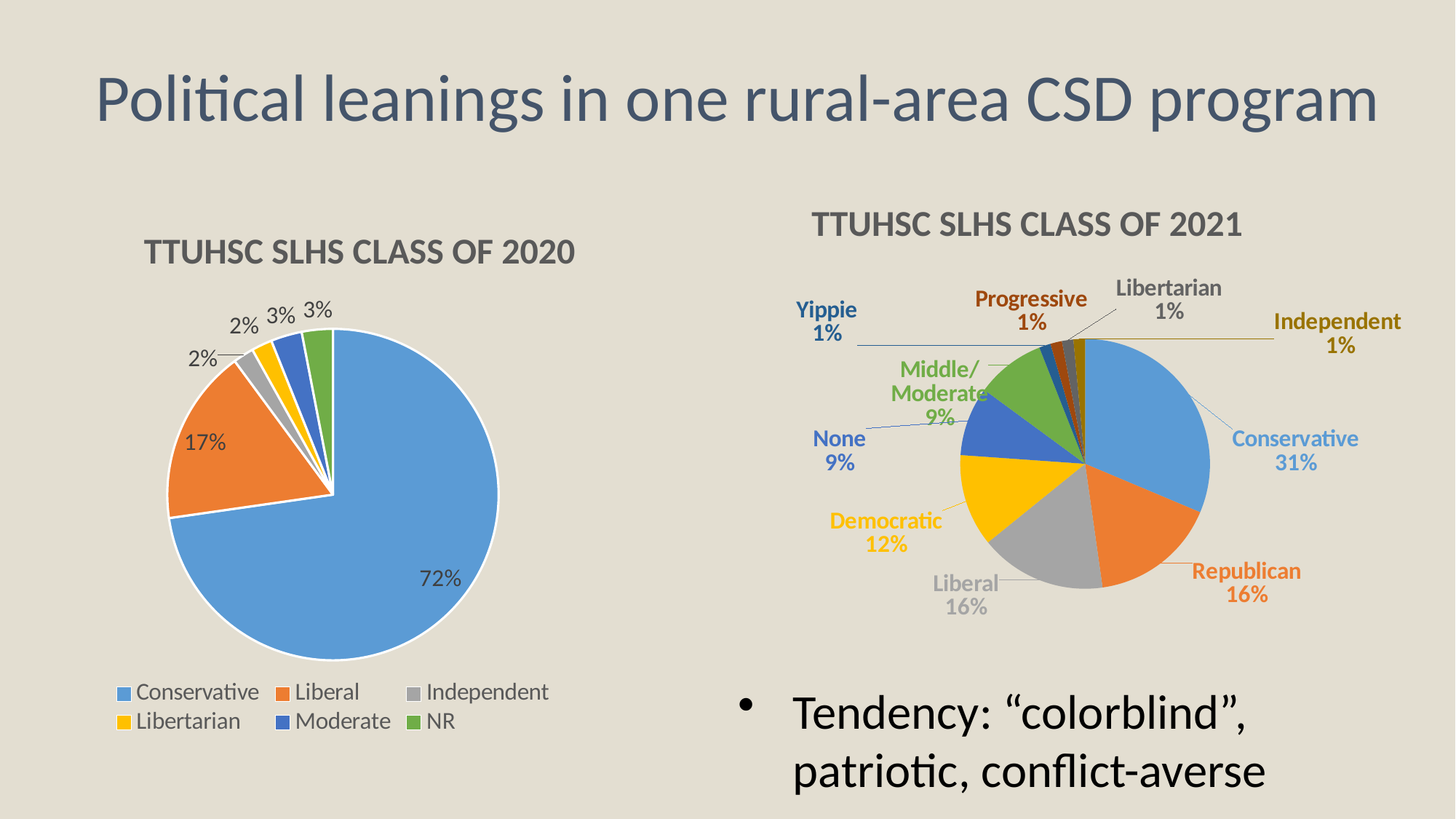
In the TTUHSC SLHS Class of 2021 chart, what percentage is Middle/Moderate? 9% In the TTUHSC SLHS Class of 2020 chart, what percentage is Liberal? 17% How many categories are shown in the TTUHSC SLHS Class of 2021 chart? 10 In the TTUHSC SLHS Class of 2020 chart, what is the difference between the Conservative and Liberal shares? 55% In the TTUHSC SLHS Class of 2020 chart, which category has the largest share? Conservative In the TTUHSC SLHS Class of 2021 chart, what is the difference between the Conservative and Republican shares? 15% In the TTUHSC SLHS Class of 2021 chart, which category has the largest share? Conservative What type of chart is the TTUHSC SLHS Class of 2020 chart? Pie chart In the TTUHSC SLHS Class of 2021 chart, which is larger, Democratic or None? Democratic In the TTUHSC SLHS Class of 2020 chart, what percentage is Conservative? 72% In the TTUHSC SLHS Class of 2021 chart, what percentage is Democratic? 12% In the TTUHSC SLHS Class of 2021 chart, what percentage is Conservative? 31%